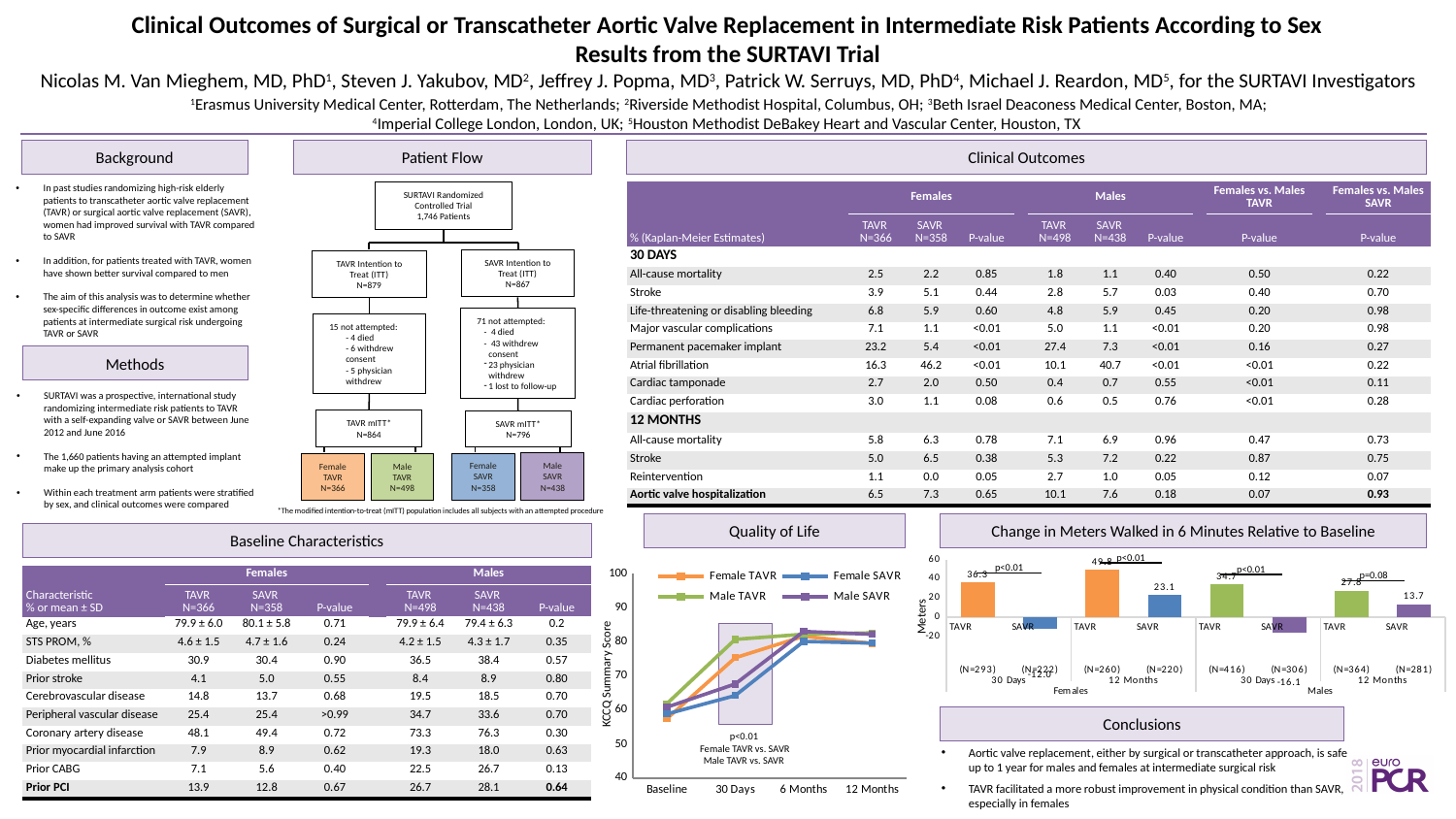
In the Change in Meters Walked chart, which bar has the highest value? Females TAVR at 12 Months What kind of chart is the Change in Meters Walked in 6 Minutes Relative to Baseline chart? bar chart In the Change in Meters Walked chart, what is the value for Females TAVR at 12 Months? 49.8 In the Quality of Life chart, is the Female TAVR value at Baseline greater or less than 70? less In the Quality of Life chart, is the Female TAVR value at 12 Months greater or less than 70? greater What kind of chart is the Quality of Life chart? line chart How many series does the legend of the Quality of Life chart list? 4 In the Change in Meters Walked chart, which is larger at 12 Months: Females TAVR or Males TAVR? Females TAVR How many time points are shown on the x axis of the Quality of Life chart? 4 In the Quality of Life chart, do the KCCQ Summary Scores rise or fall from Baseline to 12 Months? rise In the Change in Meters Walked chart, what is the value for Males SAVR at 12 Months? 13.7 In the Change in Meters Walked chart, what is the difference between the Females TAVR and Females SAVR values at 12 Months? 26.7